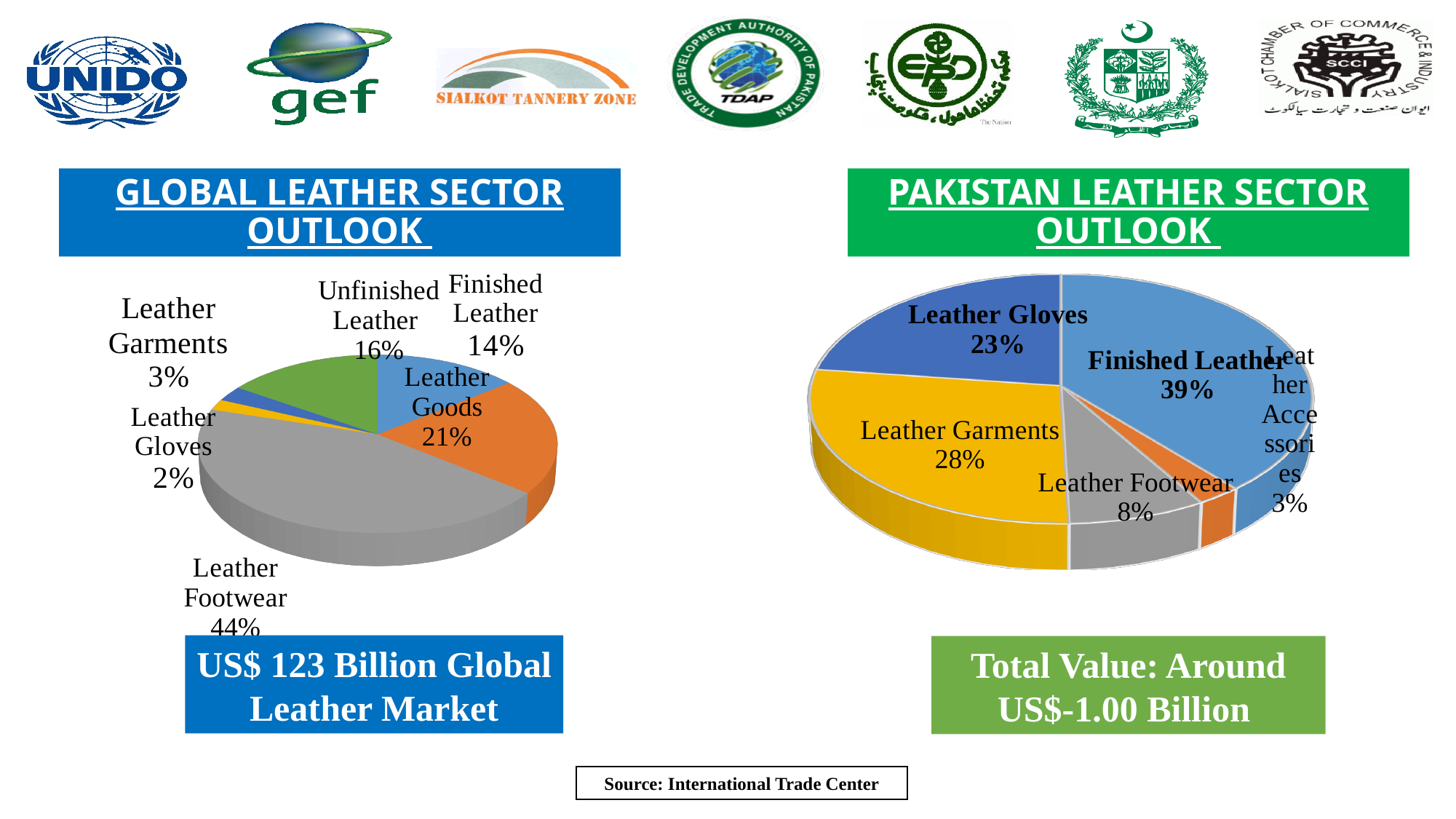
In the Global Leather Sector Outlook pie chart, what share does Leather Footwear have? 44% What kind of chart is used for the Pakistan Leather Sector Outlook? Pie chart In the Pakistan Leather Sector Outlook pie chart, what share does Leather Footwear have? 8% In the Pakistan Leather Sector Outlook pie chart, which is larger, Leather Garments or Leather Gloves? Leather Garments In the Pakistan Leather Sector Outlook pie chart, which category has the largest share? Finished Leather In the Global Leather Sector Outlook pie chart, which category has the largest share? Leather Footwear In the Pakistan Leather Sector Outlook pie chart, what is the difference between the shares of Leather Garments and Leather Footwear? 20% In the Global Leather Sector Outlook pie chart, which category has the smallest share? Leather Gloves In the Global Leather Sector Outlook pie chart, what share does Unfinished Leather have? 16% In the Global Leather Sector Outlook pie chart, what is the difference between the shares of Leather Goods and Finished Leather? 7% How many categories are shown in the Global Leather Sector Outlook pie chart? 6 In the Pakistan Leather Sector Outlook pie chart, what share does Finished Leather have? 39%